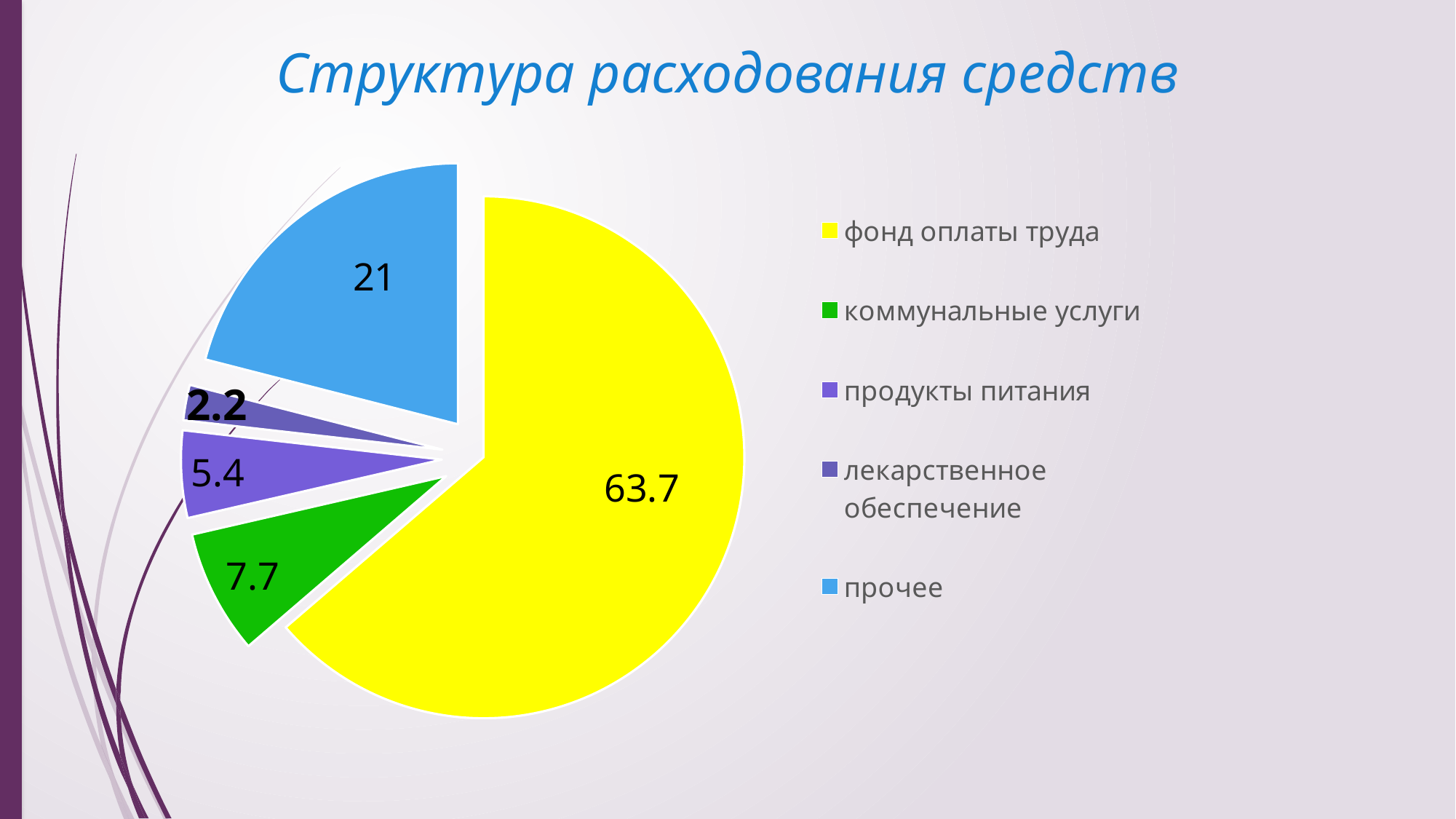
How many categories does the pie chart have? 5 Which category has the largest slice of the pie? фонд оплаты труда What is the value for прочее? 21 What is the value for коммунальные услуги? 7.7 What is the value for фонд оплаты труда? 63.7 What is the value for продукты питания? 5.4 What is the title of the chart? Структура расходования средств Which is larger, the value for коммунальные услуги or the value for продукты питания? коммунальные услуги What is the difference between the values for фонд оплаты труда and прочее? 42.7 Which category has the smallest slice of the pie? лекарственное обеспечение What is the value for лекарственное обеспечение? 2.2 What kind of chart is shown on the slide? pie chart